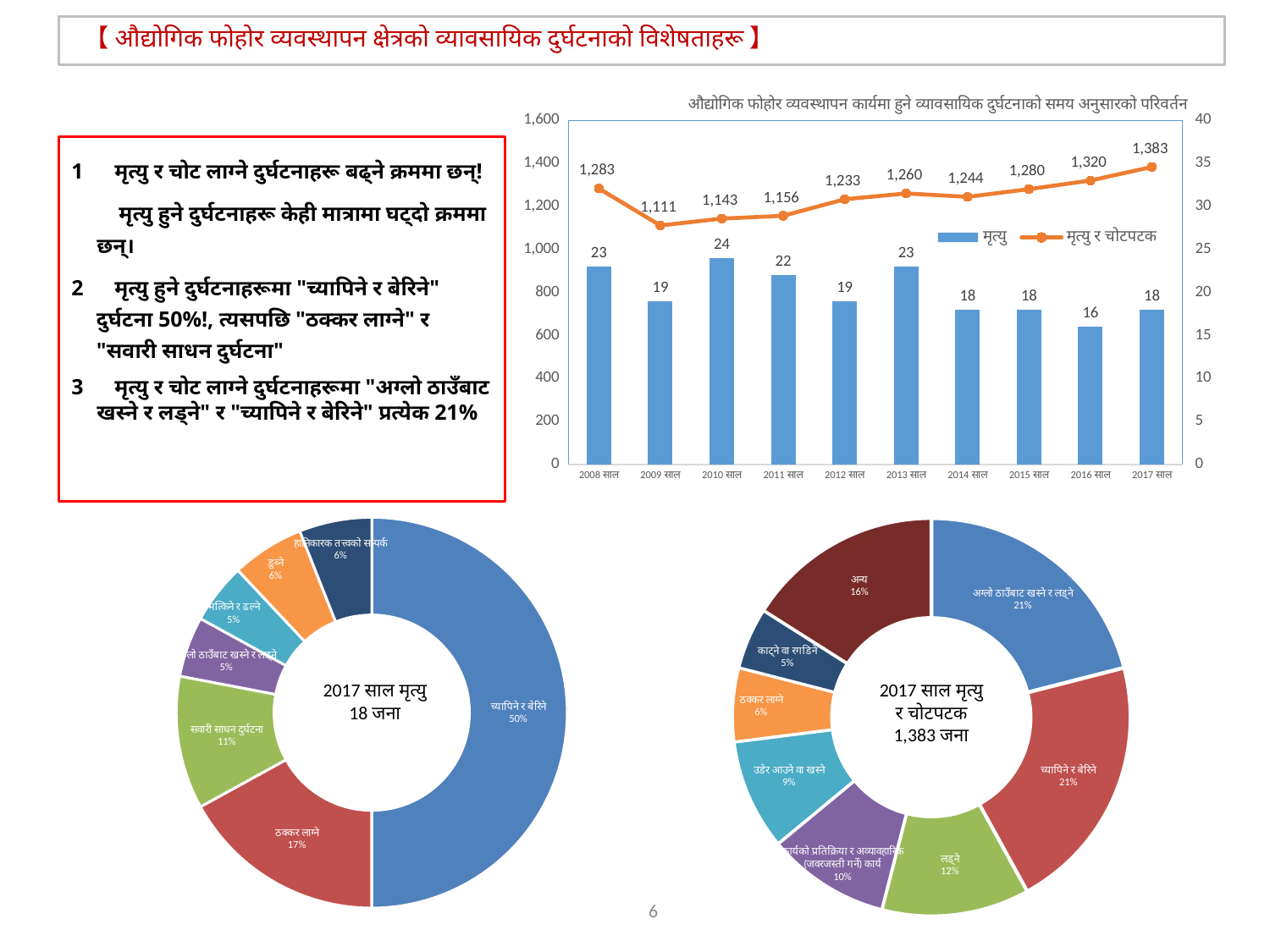
In the top-right chart, what is the मृत्यु bar value for 2010 साल? 24 In the top-right chart, what is the difference between the मृत्यु र चोटपटक values for 2017 साल and 2008 साल? 100 In the bottom-right donut chart (2017 साल मृत्यु र चोटपटक 1,383 जना), what share does लड्ने have? 12% In the top-right chart, what is the value of the मृत्यु र चोटपटक line for 2017 साल? 1,383 In the top-right chart, which year has the lowest value on the मृत्यु र चोटपटक line? 2009 साल How many series does the legend of the top-right chart list? 2 In the top-right chart, is the मृत्यु bar value for 2008 साल larger or smaller than that for 2009 साल? larger In the bottom-left donut chart (2017 साल मृत्यु 18 जना), what share does ठक्कर लाग्ने have? 17% In the top-right chart, which year has the lowest मृत्यु bar value? 2016 साल In the bottom-right donut chart (2017 साल मृत्यु र चोटपटक 1,383 जना), what is the difference between the shares of अन्य and काट्ने वा रगडिने? 11% In the bottom-left donut chart (2017 साल मृत्यु 18 जना), what share does च्यापिने र बेरिने have? 50% How many years are shown on the x axis of the top-right chart? 10